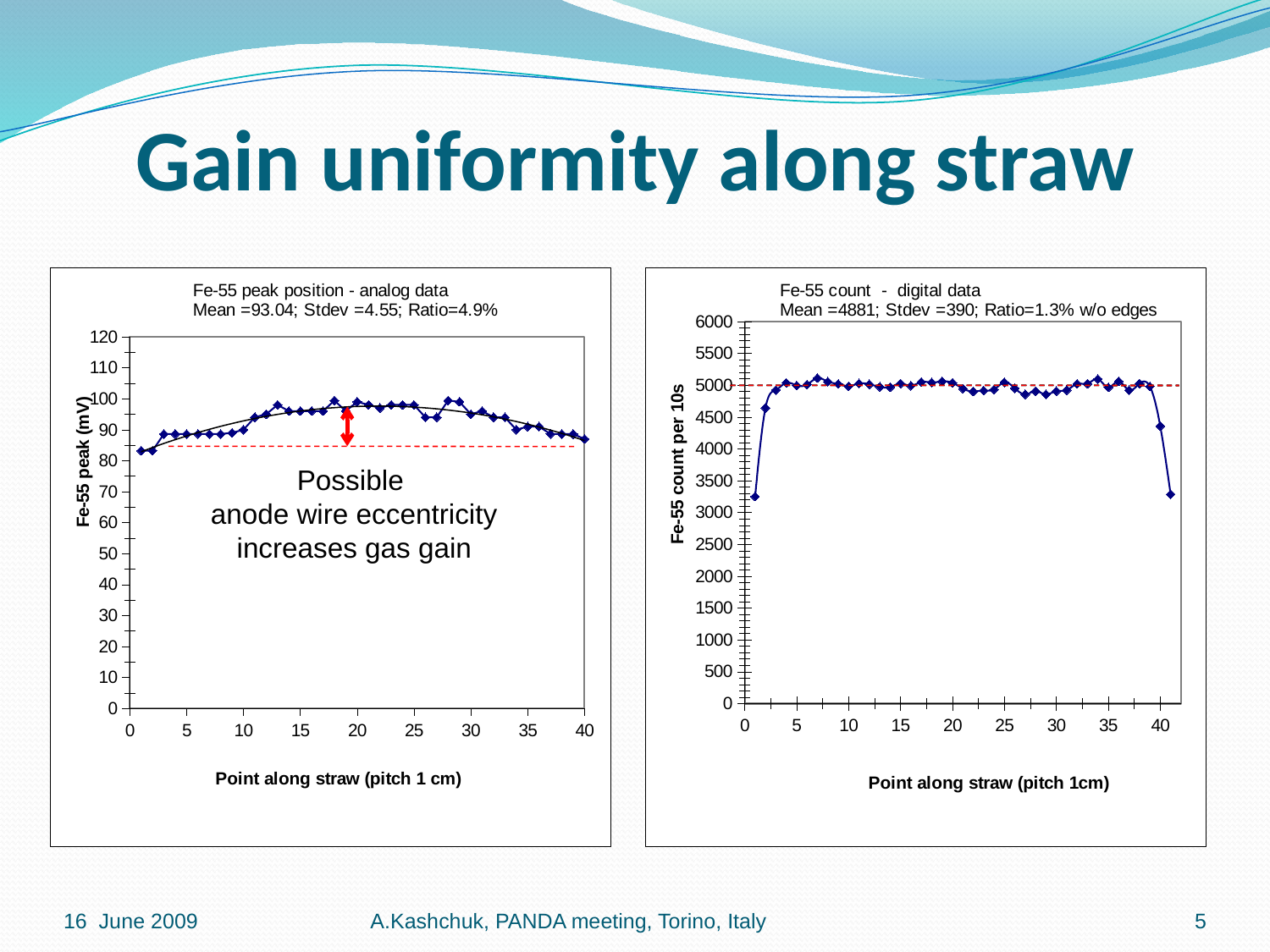
In the left chart (Fe-55 peak position), is the value at point 20 along the straw greater or less than 90? greater In the right chart (Fe-55 count), is the value at point 1 along the straw greater or less than 4000? less What is the y-axis label of the right chart (Fe-55 count - digital data)? Fe-55 count per 10s In the left chart (Fe-55 peak position), is the value at point 1 along the straw greater or less than 90? less What kind of chart is the left chart, 'Fe-55 peak position - analog data'? line chart What kind of chart is the right chart, 'Fe-55 count - digital data'? line chart In the left chart (Fe-55 peak position), which has the larger value: point 1 or point 20 along the straw? point 20 In the right chart (Fe-55 count), do the values rise or fall between point 38 and point 41 along the straw? fall In the left chart (Fe-55 peak position), do the values rise or fall between point 1 and point 13 along the straw? rise In the right chart (Fe-55 count), which has the larger value: point 10 or point 41 along the straw? point 10